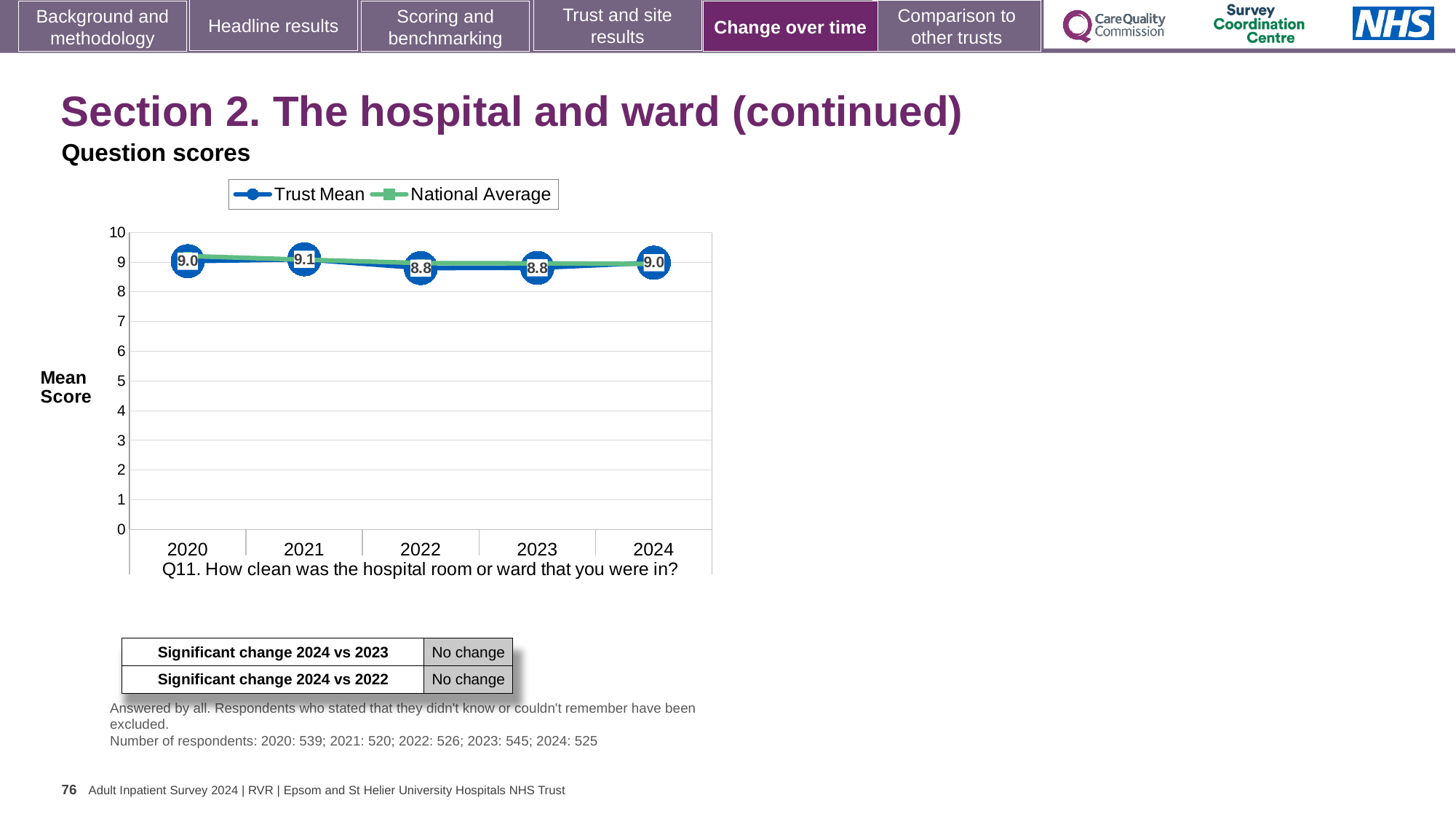
Which year has the larger Trust Mean score, 2021 or 2023? 2021 What kind of chart is shown on the slide? Line chart What is the difference between the Trust Mean scores for 2021 and 2022? 0.3 How many years are plotted on the x axis? 5 Is the National Average value for 2022 greater or less than 8? greater What is the Trust Mean score for 2024? 9.0 What is the Trust Mean score for 2023? 8.8 Does the Trust Mean score rise or fall from 2021 to 2022? Fall How many series does the legend list? 2 What is the lowest Trust Mean score shown on the chart? 8.8 What is the Trust Mean score for 2021? 9.1 In which year is the Trust Mean score highest? 2021